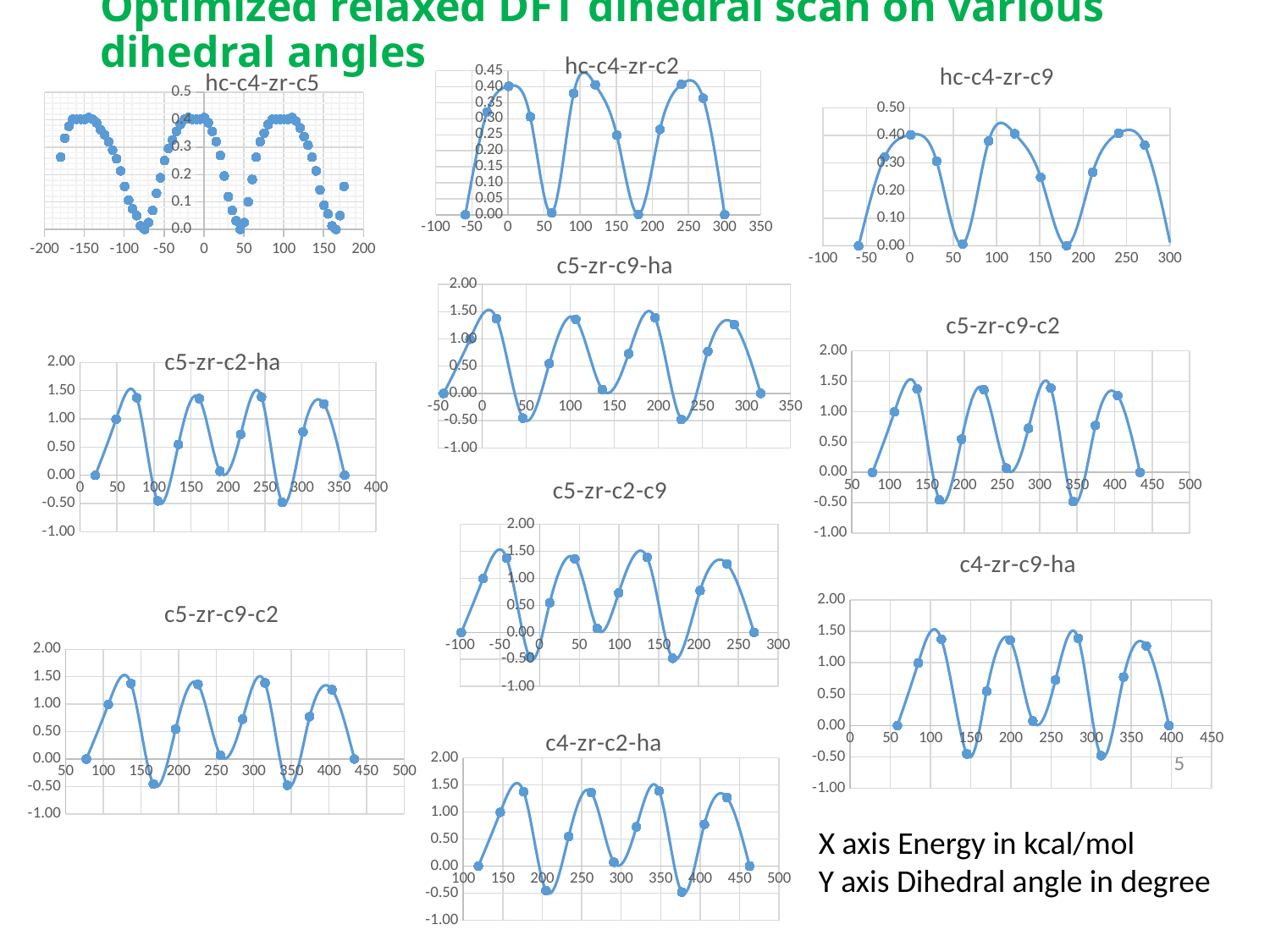
In the hc-c4-zr-c9 chart, is the value at a dihedral angle of 0 greater or less than 0.30? greater What kind of chart is the hc-c4-zr-c5 chart in the top-left corner? scatter chart How many charts are shown on the slide? 10 What is the highest tick value on the vertical axis of the hc-c4-zr-c2 chart? 0.45 In the c5-zr-c9-ha chart, is the value at a dihedral angle of 50 greater or less than 0.00? less In the c5-zr-c2-ha chart, is the value at a dihedral angle of 75 greater or less than 1.00? greater What is the lowest tick value on the vertical axis of the c5-zr-c2-c9 chart? -1.00